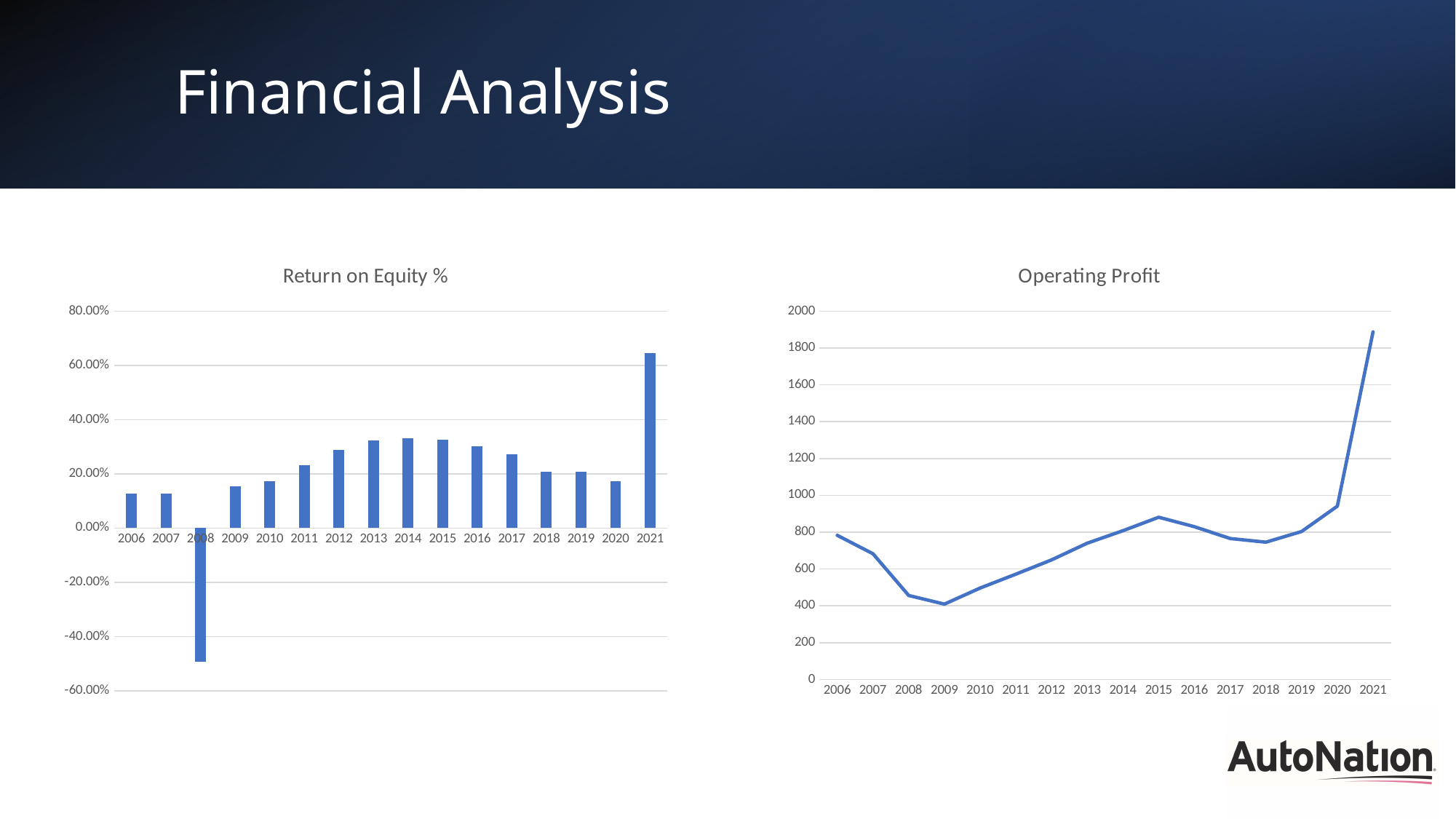
In the Return on Equity % chart, which year has the lowest return on equity? 2008 In the Return on Equity % chart, how many years are shown on the x axis? 16 In the Return on Equity % chart, is the value for 2008 greater or less than -40.00%? less In the Operating Profit chart, which year has the larger operating profit, 2006 or 2007? 2006 In the Operating Profit chart, which year has the lowest operating profit? 2009 In the Return on Equity % chart, which year has the highest return on equity? 2021 In the Operating Profit chart, does operating profit rise or fall from 2009 to 2015? rise In the Return on Equity % chart, is the value for 2021 greater or less than 60.00%? greater What kind of chart is the Return on Equity % chart? bar chart In the Operating Profit chart, is the value for 2021 greater or less than 1800? greater In the Operating Profit chart, which year has the highest operating profit? 2021 What kind of chart is the Operating Profit chart? line chart